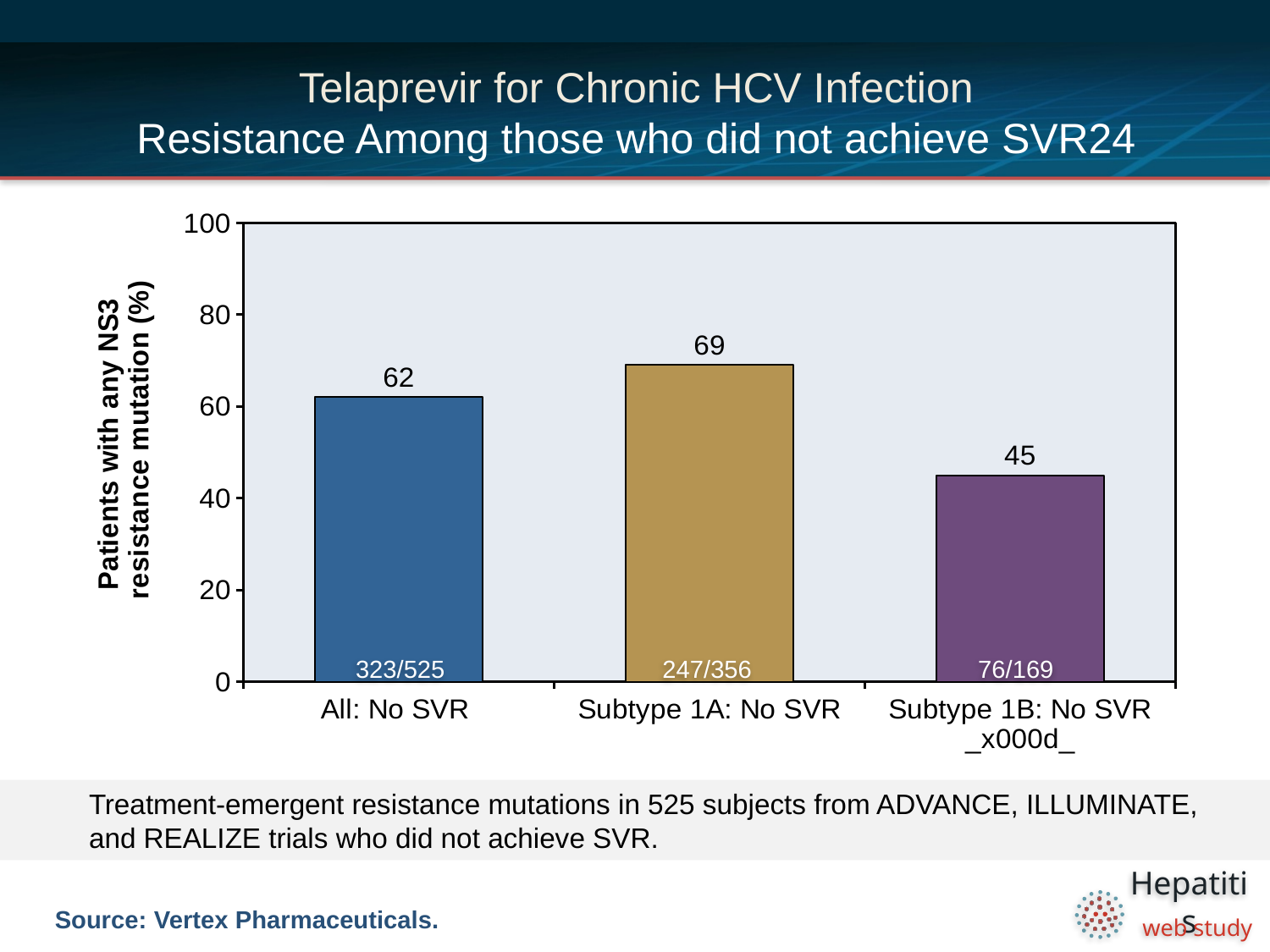
What is the difference between the values for Subtype 1A: No SVR and Subtype 1B: No SVR? 24 How many categories are shown on the chart? 3 What is the value for Subtype 1B: No SVR? 45 What fraction is printed inside the bar for Subtype 1A: No SVR? 247/356 What is the difference between the values for Subtype 1A: No SVR and All: No SVR? 7 What is the value for Subtype 1A: No SVR? 69 Is the value for Subtype 1B: No SVR greater or less than 60? less What is the value for All: No SVR? 62 Which category has the lowest value? Subtype 1B: No SVR What kind of chart is shown on the slide? bar chart Which is larger, the value for All: No SVR or the value for Subtype 1B: No SVR? All: No SVR Which category has the highest value? Subtype 1A: No SVR